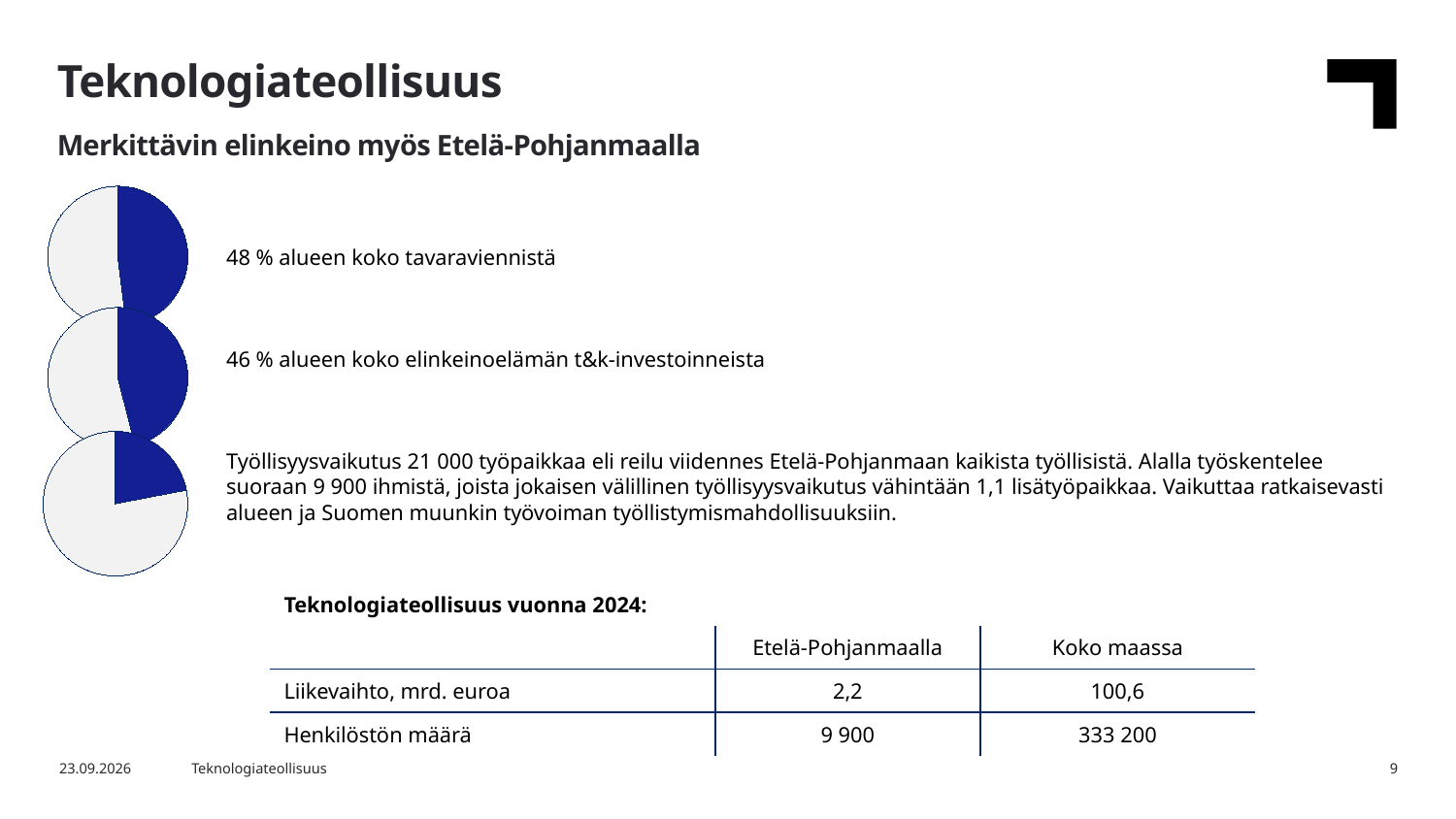
What is the difference between the shares shown by the top pie chart (48 %) and the middle pie chart (46 %)? 2 percentage points In the middle pie chart, what share of the region's business R&D investments does the blue slice represent? 46 % What does the bottom pie chart illustrate, according to the text next to it? the employment effect, just over a fifth of all employed people in Etelä-Pohjanmaa What kind of chart is shown at the top left of the slide? pie chart Which pie chart has the larger blue slice, the top one (48 %) or the middle one (46 %)? the top one What colour is the highlighted slice in each pie chart? blue Which of the three pie charts has the smallest blue slice? the bottom one In the top pie chart, what share of the region's total goods exports does the blue slice represent? 48 % In the top pie chart, is the blue slice larger or smaller than the grey slice? smaller In the bottom pie chart, is the blue slice larger or smaller than the grey slice? smaller How many slices does the top pie chart have? 2 How many pie charts are on the slide? 3